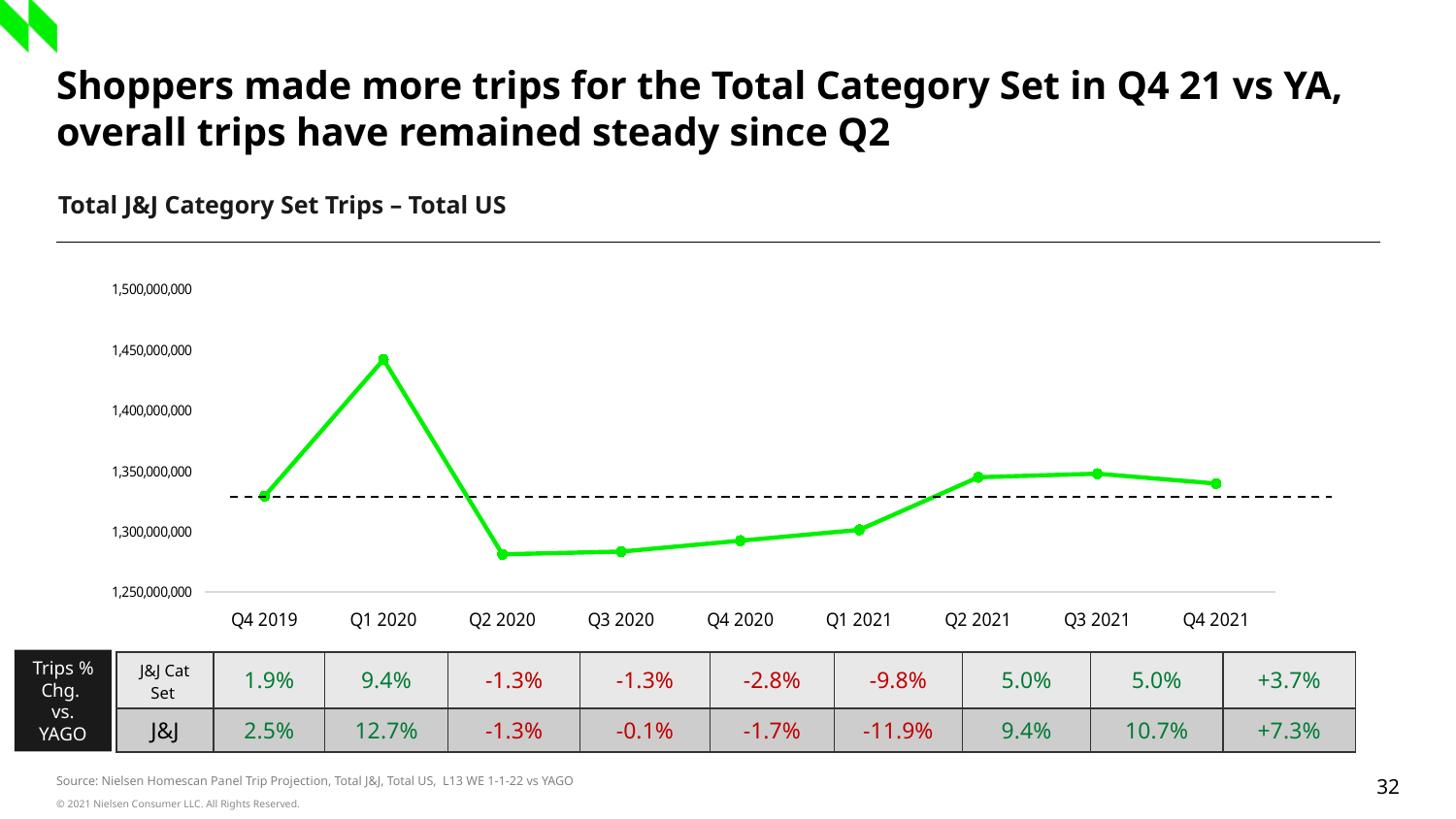
What is the title of the chart? Total J&J Category Set Trips – Total US In the table below the chart, what is the Trips % Chg. vs. YAGO for J&J Cat Set in Q4 2021? +3.7% What kind of chart is shown on the slide? line chart Do trips rise or fall from Q2 2020 to Q2 2021? rise How many quarters are plotted on the x axis of the line chart? 9 Is the value for Q4 2019 greater or less than 1,350,000,000? less Is the value for Q1 2020 greater or less than 1,400,000,000? greater Which quarter has the lowest number of trips in the line chart? Q2 2020 Which quarter has the highest number of trips in the line chart? Q1 2020 In the table below the chart, what is the Trips % Chg. vs. YAGO for J&J in Q1 2021? -11.9% Is the value for Q2 2020 greater or less than 1,300,000,000? less Do trips rise or fall from Q1 2020 to Q2 2020? fall